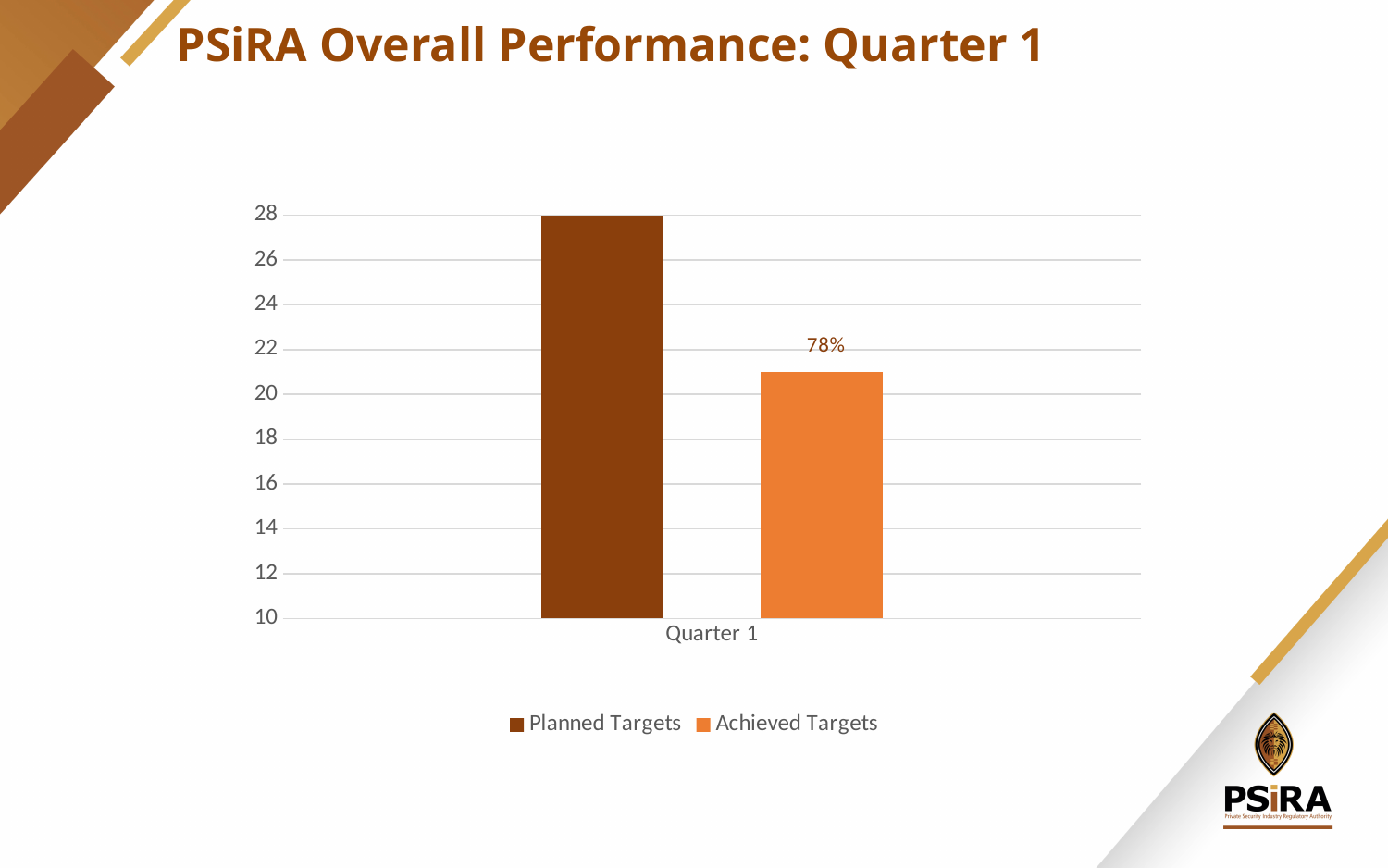
How many series does the legend list? 2 Is the value for Achieved Targets greater or less than 20? greater How many categories are shown on the x axis? 1 Which series has the lowest bar in the chart? Achieved Targets Which series has the taller bar for Quarter 1, Planned Targets or Achieved Targets? Planned Targets What is the title of the slide's chart? PSiRA Overall Performance: Quarter 1 What type of chart is shown on the slide? Bar chart What is the lowest value shown on the vertical axis? 10 What is the value of the Planned Targets bar for Quarter 1? 28 What data label is printed above the Achieved Targets bar? 78% What are the two series named in the legend? Planned Targets and Achieved Targets Is the value for Achieved Targets greater or less than 24? less